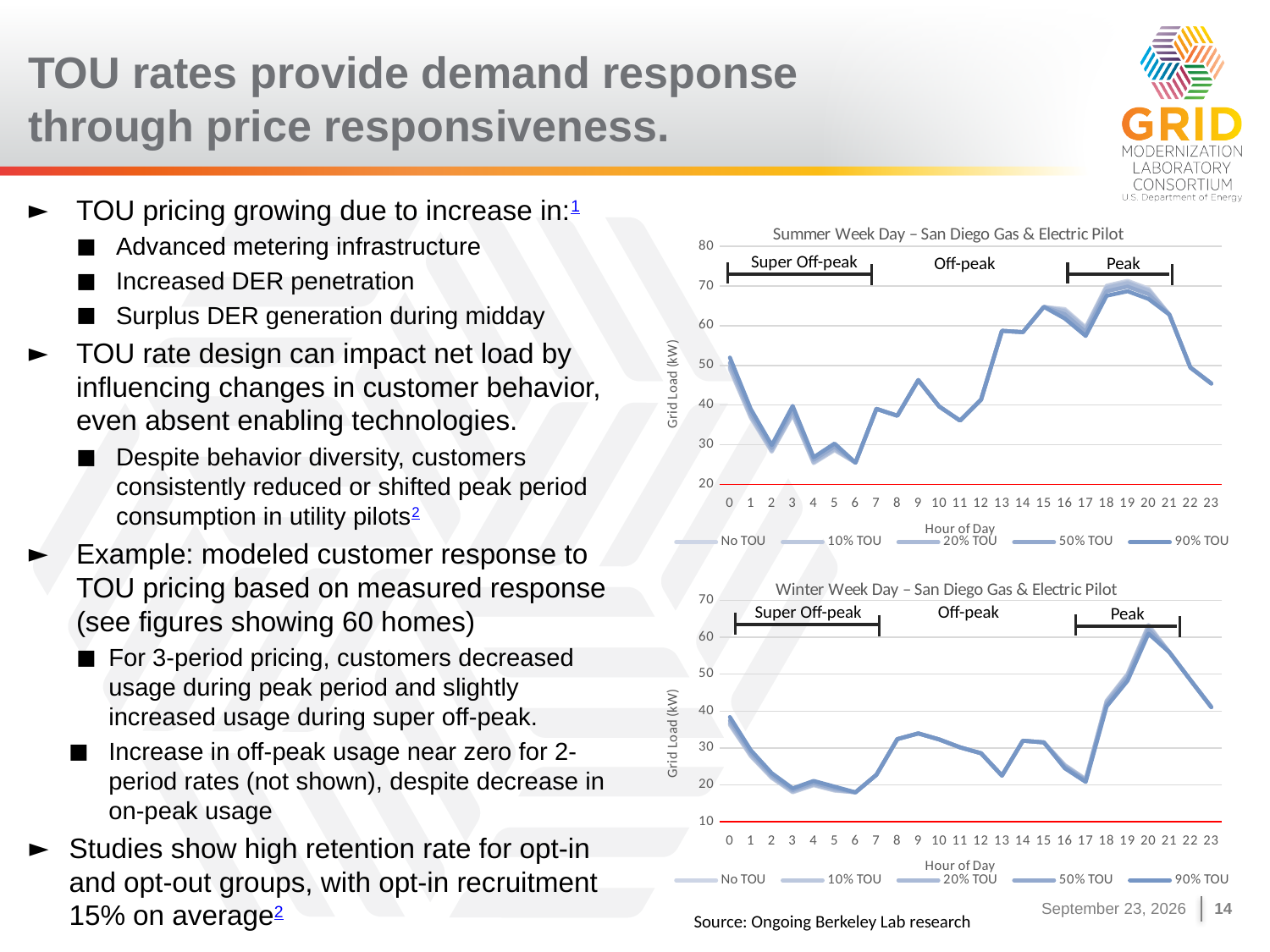
In the Summer Week Day chart, is the grid load at hour 4 greater or less than 30 kW? less In the Winter Week Day chart, at which hour of the day is the grid load highest? 20 What kind of chart is the Summer Week Day – San Diego Gas & Electric Pilot chart? Line chart In the Winter Week Day chart, is the grid load at hour 20 greater or less than 50 kW? greater How many hours of the day are plotted along the x axis of the Summer Week Day chart? 24 What is the y-axis label on the Summer Week Day chart? Grid Load (kW) In the Summer Week Day chart, is the grid load at hour 19 greater or less than 60 kW? greater In the Winter Week Day chart, does the grid load rise or fall from hour 17 to hour 20? Rise In the Summer Week Day chart, is the grid load higher at hour 19 or at hour 4? Hour 19 In the Summer Week Day chart, does the grid load rise or fall from hour 0 to hour 4? Fall How many series does the legend of the Winter Week Day – San Diego Gas & Electric Pilot chart list? 5